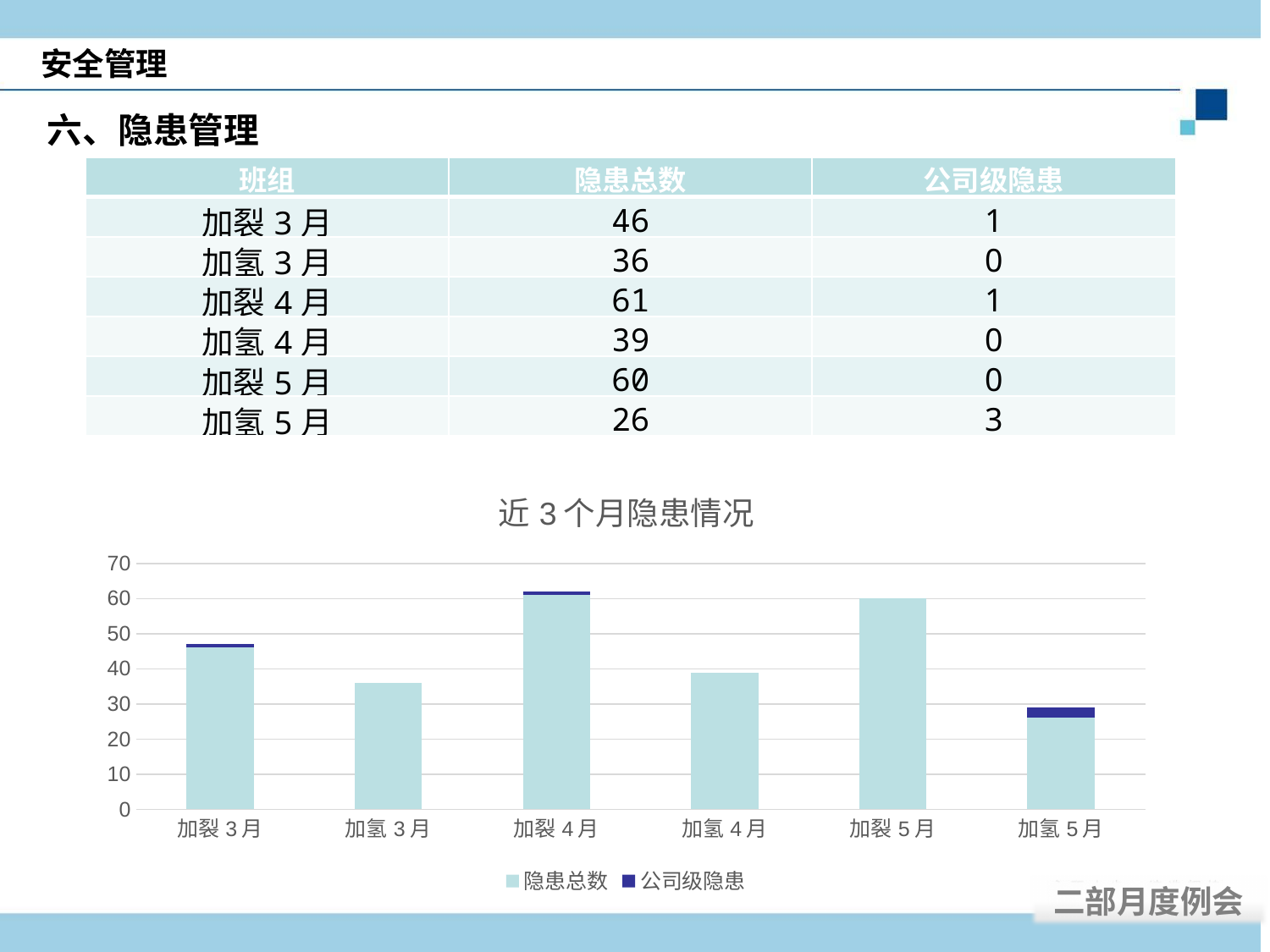
What is the 隐患总数 value for 加裂4月? 61 What is the title of the chart? 近3个月隐患情况 Is the 隐患总数 value for 加氢3月 greater or less than 40? less How many categories are shown on the x axis of the chart? 6 What is the 公司级隐患 value for 加氢5月? 3 Is the 隐患总数 value for 加裂5月 greater or less than 50? greater What is the total height of the stacked bar for 加氢5月 (隐患总数 plus 公司级隐患)? 29 Which category has the highest 隐患总数 value in the chart? 加裂4月 How many series does the chart legend list? 2 Which category has the lowest 隐患总数 value in the chart? 加氢5月 Which is larger, the 隐患总数 value for 加裂3月 or for 加氢4月? 加裂3月 What kind of chart is shown on the slide? bar chart